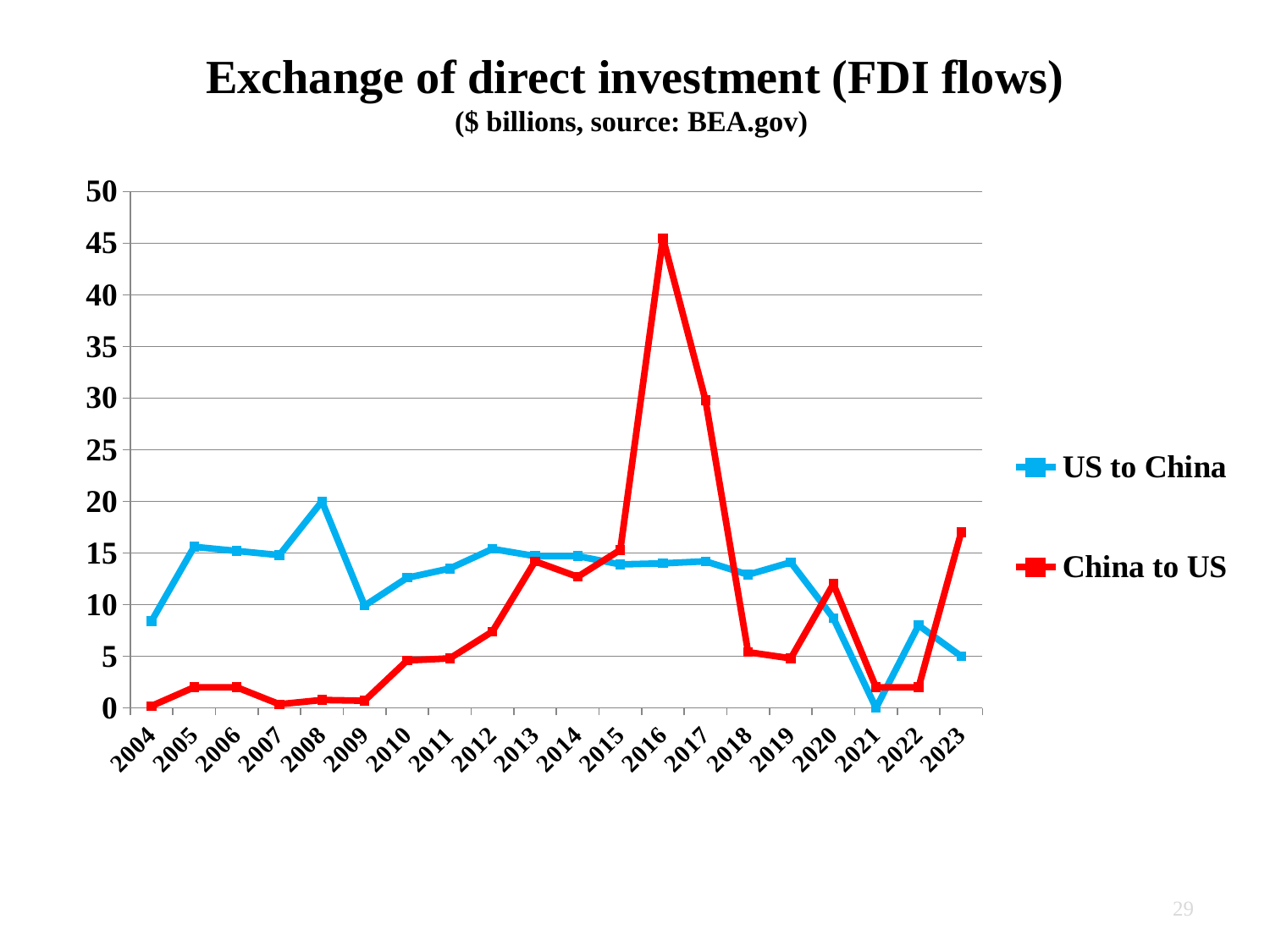
Is the China to US value for 2016 greater or less than 40? greater Is the China to US value for 2009 greater or less than 5? less Is the US to China value for 2008 greater or less than 15? greater What colour is the US to China line? blue Does the China to US series rise or fall from 2016 to 2018? fall In which year does the US to China series reach its highest value? 2008 In 2016, which series has the larger value, US to China or China to US? China to US In which year does the US to China series reach its lowest value? 2021 How many years are plotted along the x axis? 20 What kind of chart is shown on the slide? line chart In which year does the China to US series reach its highest value? 2016 How many series does the legend list? 2